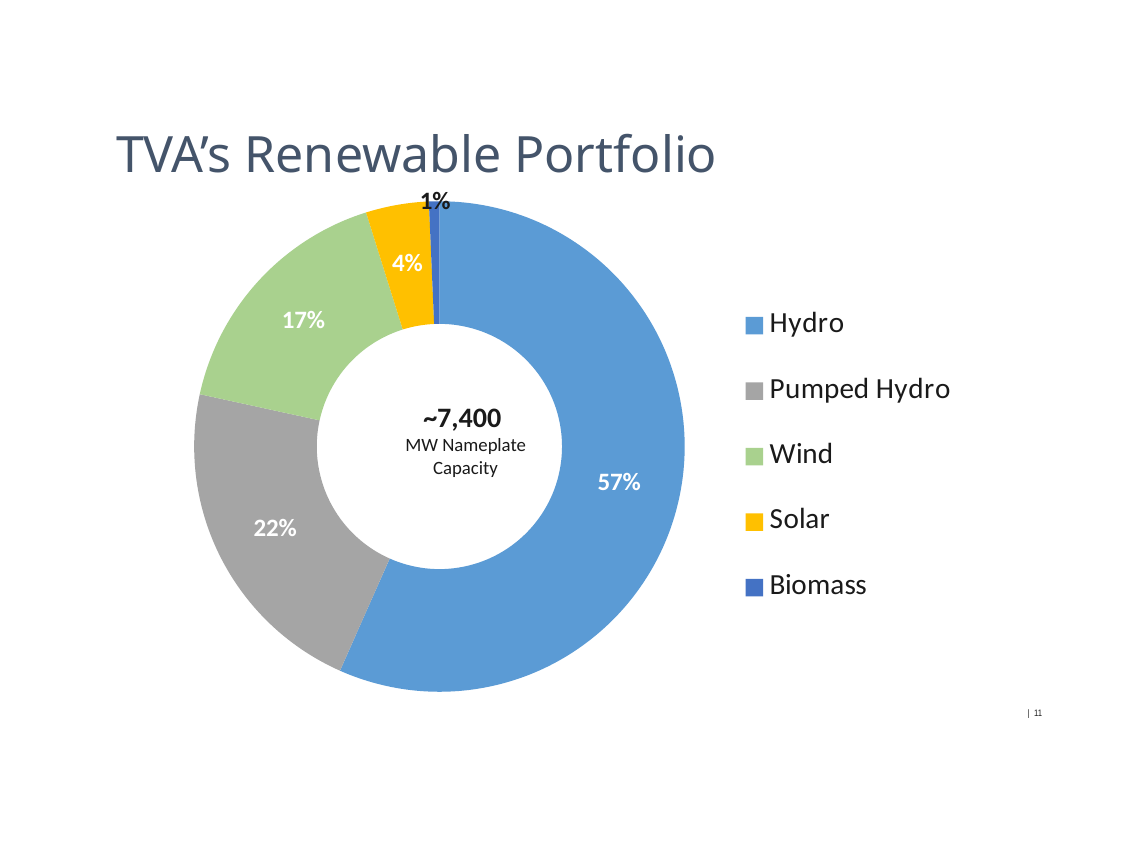
What kind of chart is shown on the slide? Doughnut chart What share of the pie does Hydro represent? 57% What share of the pie does Solar represent? 4% What share of the pie does Biomass represent? 1% Which has a larger share, Wind or Solar? Wind What is the difference in percentage points between the Hydro and Pumped Hydro shares? 35 Which category has the smallest share of the pie? Biomass How many categories does the pie chart show? 5 Which category has the largest share of the pie? Hydro What is the title of the slide containing the chart? TVA's Renewable Portfolio